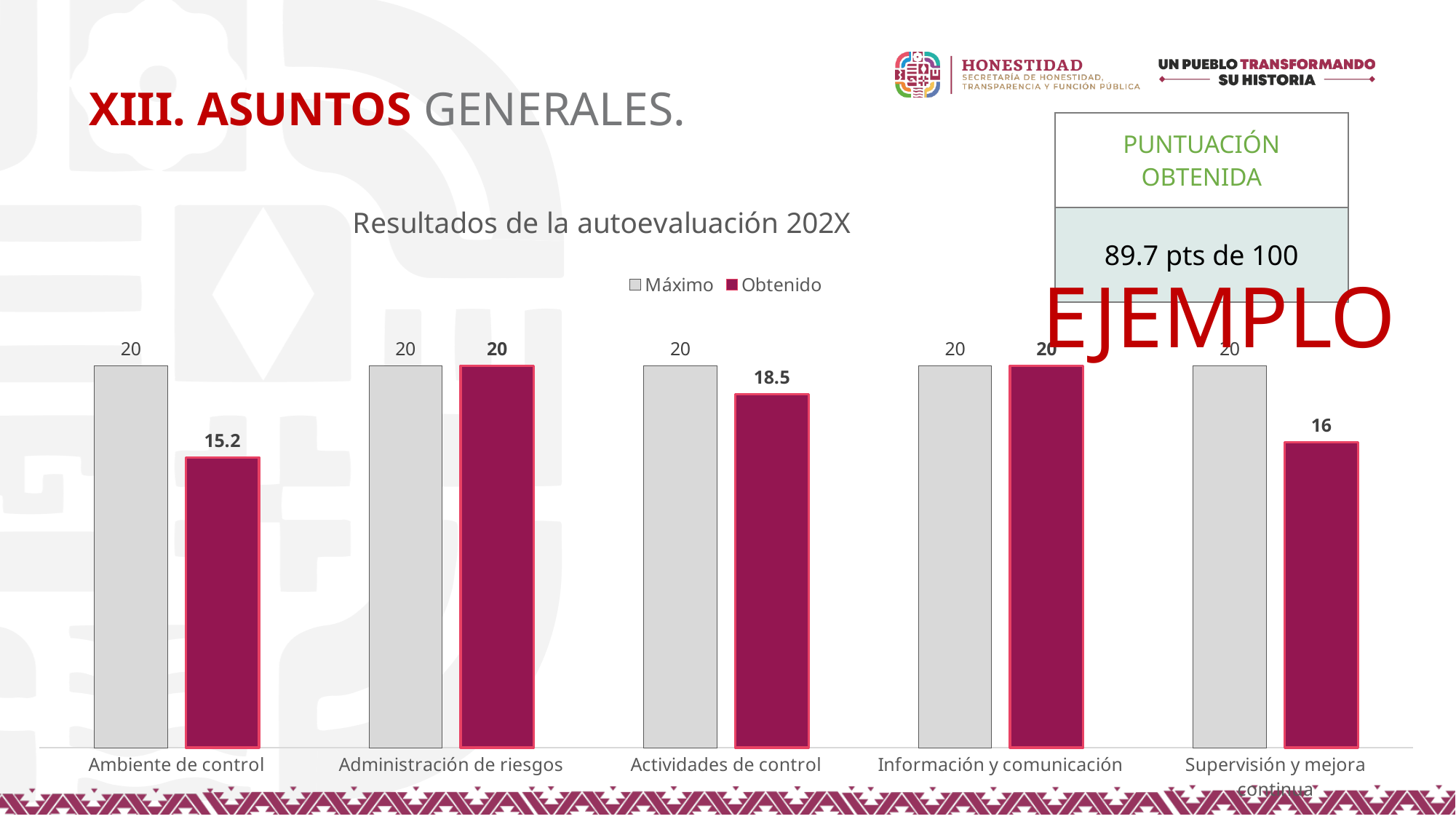
How many series does the legend list? 2 What kind of chart is shown on the slide? Bar chart What is the difference between the Máximo and Obtenido values for Ambiente de control? 4.8 What is the title of the chart? Resultados de la autoevaluación 202X How many categories are shown on the x axis? 5 What is the Obtenido value for Supervisión y mejora continua? 16 Which is larger, the Obtenido value for Actividades de control or for Supervisión y mejora continua? Actividades de control Which category has the lowest Obtenido value? Ambiente de control What is the difference between the Obtenido values for Actividades de control and Supervisión y mejora continua? 2.5 What is the Máximo value for Información y comunicación? 20 What is the Obtenido value for Actividades de control? 18.5 What is the Obtenido value for Ambiente de control? 15.2